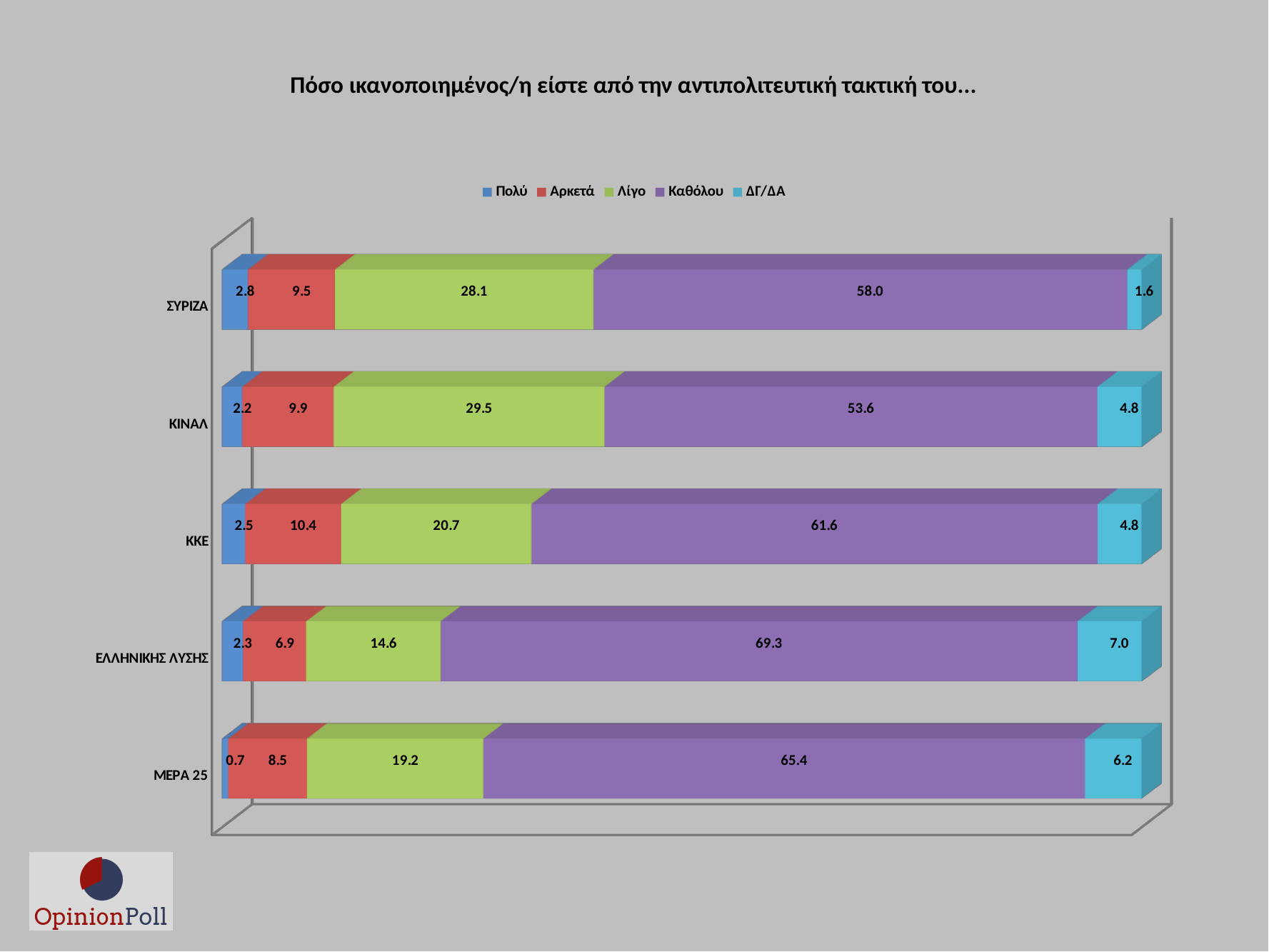
Which party has the lowest Πολύ value? ΜΕΡΑ 25 What is the Αρκετά value for ΚΚΕ? 10.4 What is the Λίγο value for ΚΙΝΑΛ? 29.5 What is the difference between the Λίγο values for ΚΙΝΑΛ and ΚΚΕ? 8.8 What kind of chart is shown on the slide? Stacked bar chart What is the Καθόλου value for ΣΥΡΙΖΑ? 58.0 Which colour represents Καθόλου in the legend? Purple What is the ΔΓ/ΔΑ value for ΕΛΛΗΝΙΚΗΣ ΛΥΣΗΣ? 7.0 How many series does the legend list? 5 How many parties are shown in the chart? 5 Which party has the highest Καθόλου value? ΕΛΛΗΝΙΚΗΣ ΛΥΣΗΣ Which is larger, the Καθόλου value for ΚΚΕ or for ΜΕΡΑ 25? ΜΕΡΑ 25